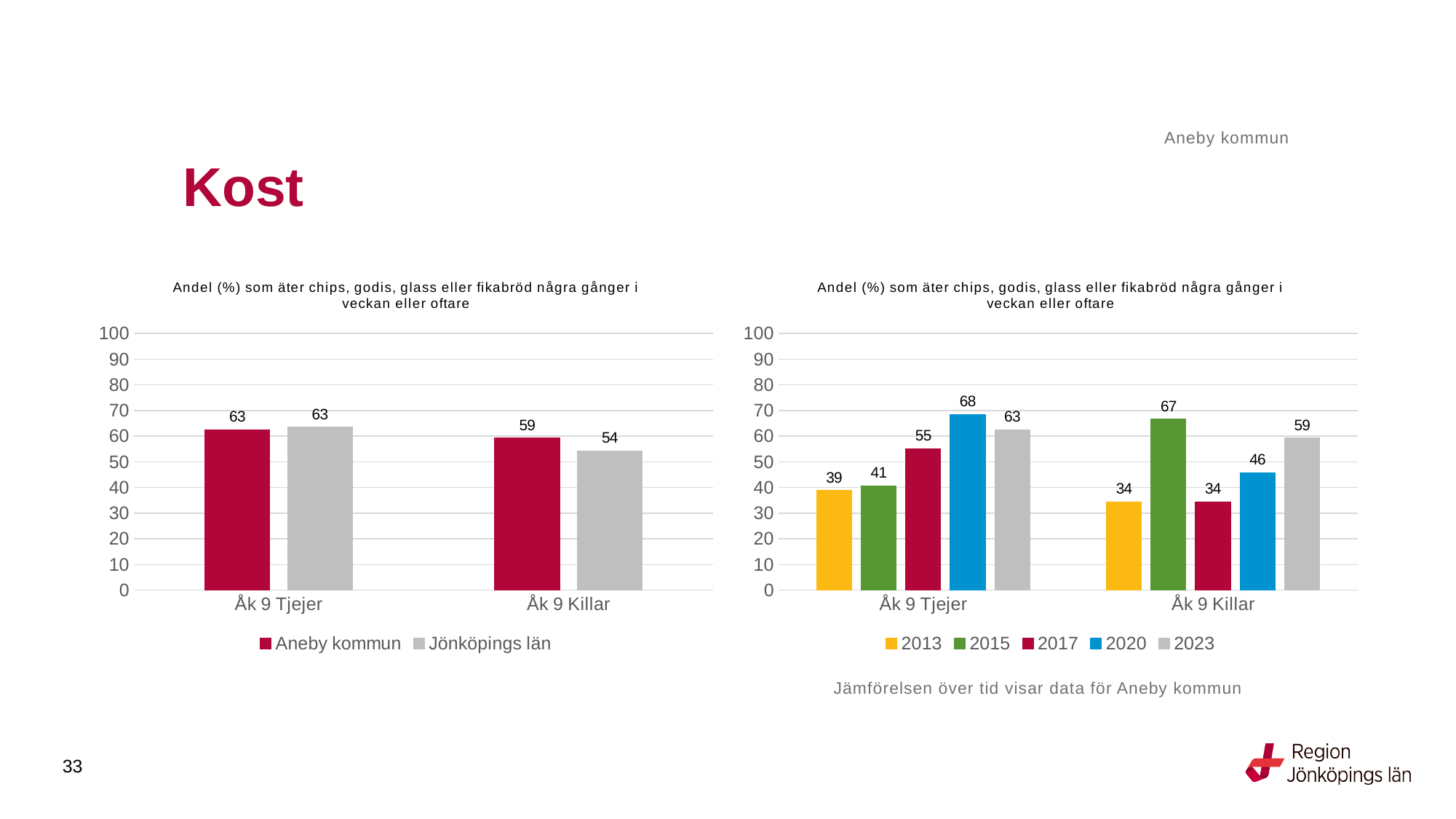
In the right chart, which is larger for Åk 9 Killar: the 2020 value or the 2023 value? 2023 In the right chart, what is the difference between the 2023 and 2013 values for Åk 9 Killar? 25 In the right chart, what is the value for 2020 for Åk 9 Tjejer? 68 In the left chart, how many series does the legend list? 2 In the right chart, which year has the lowest value for Åk 9 Tjejer? 2013 In the left chart, what is the value for Jönköpings län for Åk 9 Killar? 54 What kind of chart is the right chart? Bar chart In the left chart, what is the difference between Aneby kommun and Jönköpings län for Åk 9 Killar? 5 In the right chart, how many series does the legend list? 5 In the left chart, what is the value for Aneby kommun for Åk 9 Tjejer? 63 In the right chart, what is the value for 2015 for Åk 9 Killar? 67 In the right chart, which year has the highest value for Åk 9 Tjejer? 2020